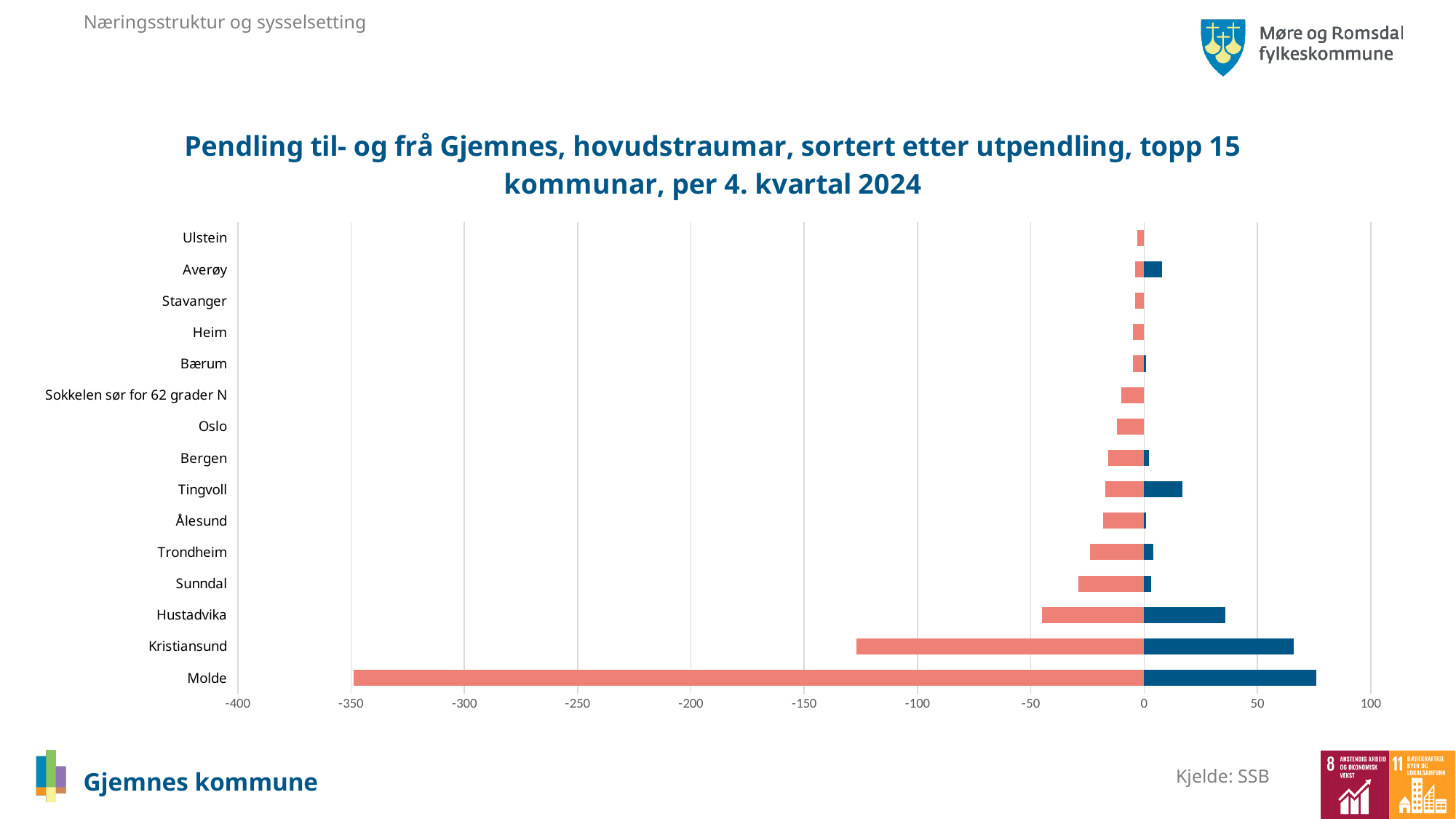
What source is cited for the chart data on the slide? SSB How many municipalities (categories) are listed on the vertical axis of the chart? 15 Is the value of the red bar for Sunndal greater or less than -50? greater Which has the larger blue bar, Kristiansund or Hustadvika? Kristiansund Is the value of the blue bar for Kristiansund greater or less than 50? greater Which municipality has the longest blue (positive) bar in the chart? Molde Is the value of the blue bar for Hustadvika greater or less than 50? less Which has the larger blue bar, Tingvoll or Averøy? Tingvoll Which municipality has the longest red (negative) bar in the chart? Molde What kind of chart is shown on the slide? bar chart